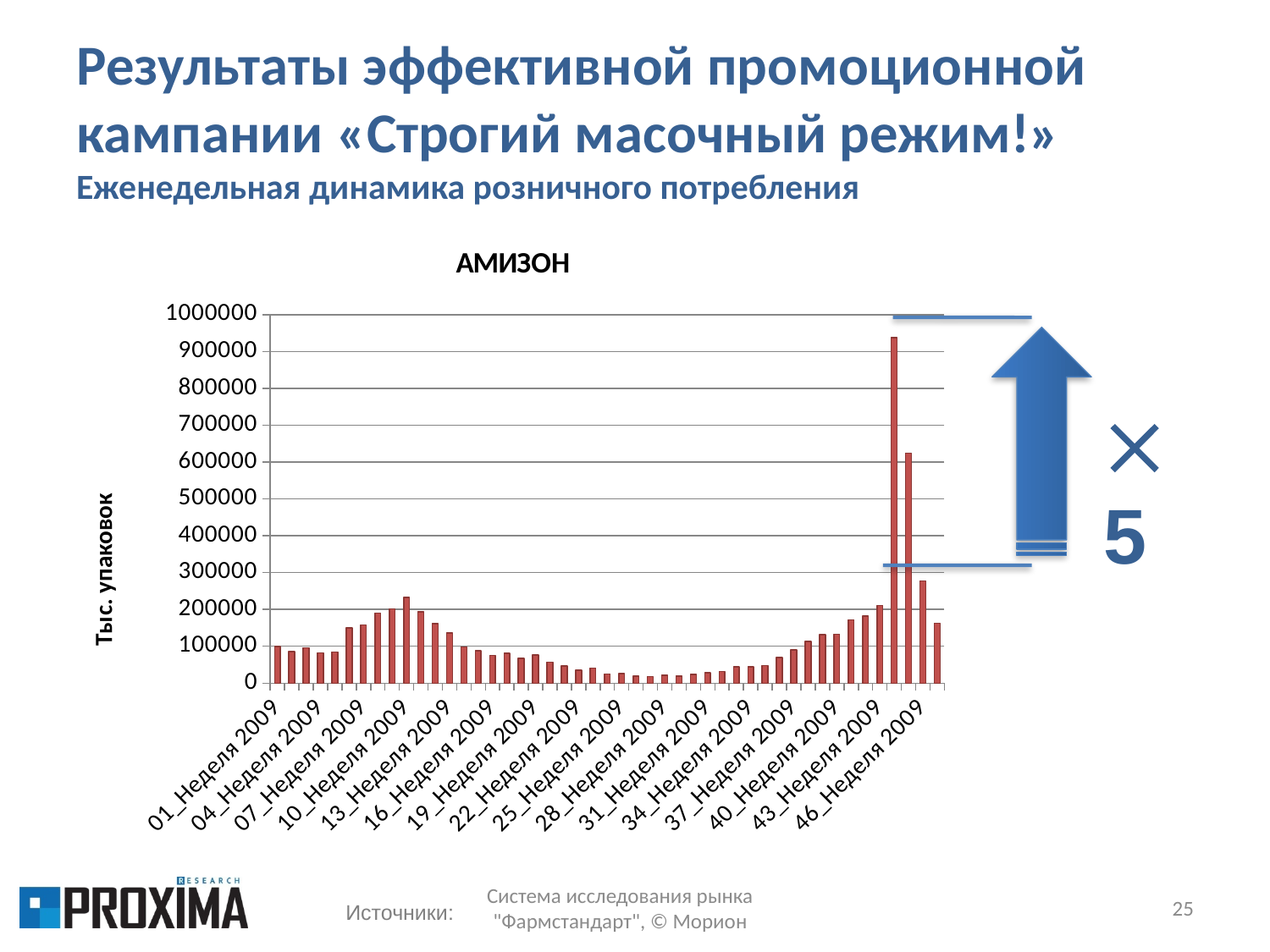
Which is larger, the value for 10_Неделя 2009 or the value for 31_Неделя 2009? 10_Неделя 2009 Is the value for 01_Неделя 2009 greater or less than 200000? less What is the label of the vertical axis of the chart? Тыс. упаковок Do the values rise or fall from 31_Неделя 2009 to 43_Неделя 2009? rise Is the value for 10_Неделя 2009 greater or less than 100000? greater Is the highest bar in the chart greater or less than 900000? greater Do the values rise or fall from 10_Неделя 2009 to 28_Неделя 2009? fall What kind of chart is shown on the slide? bar chart What is the title of the chart? АМИЗОН Which is larger, the value for 01_Неделя 2009 or the value for 28_Неделя 2009? 01_Неделя 2009